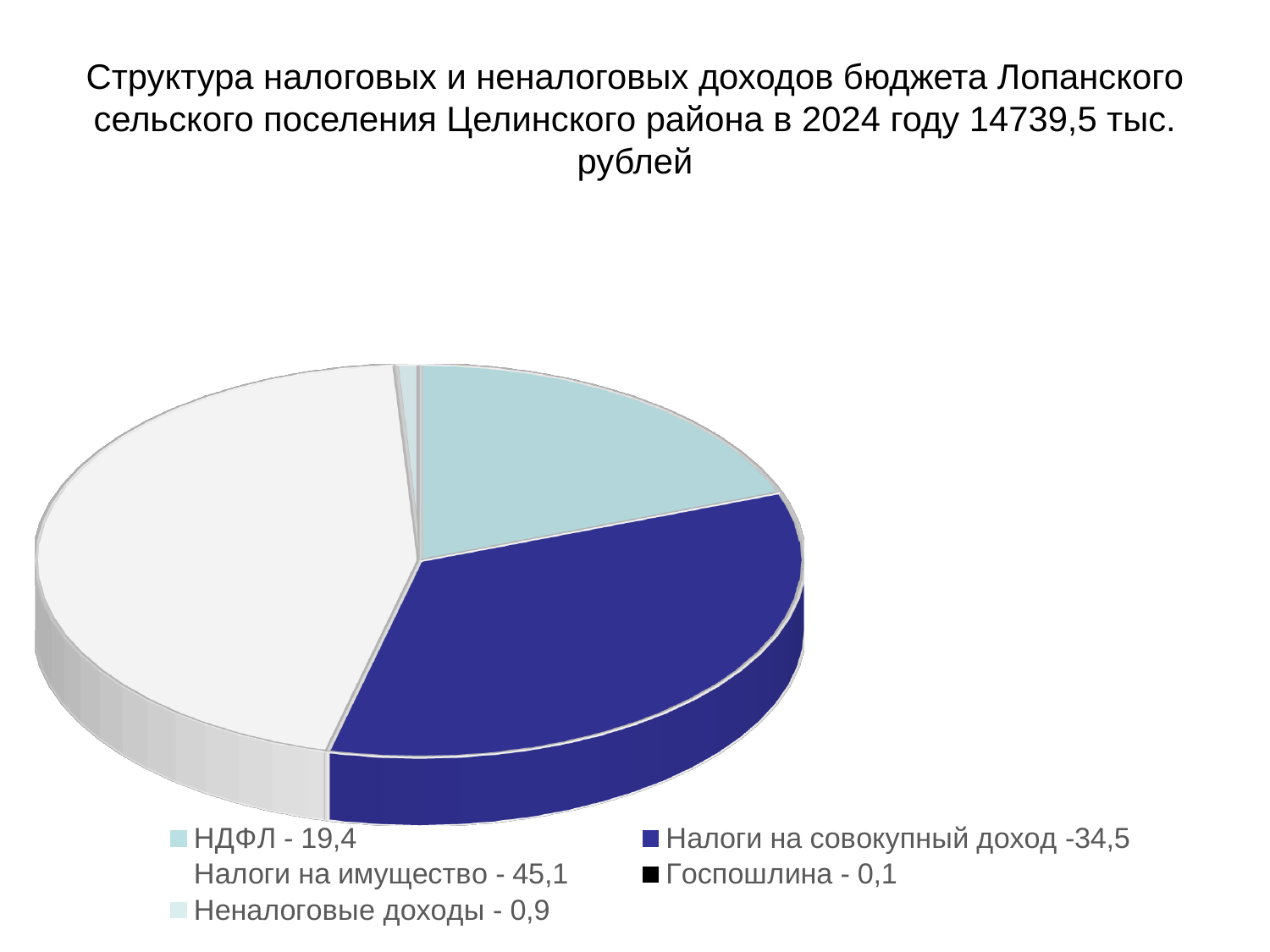
Which category has the smallest share of the pie? Госпошлина Which category has the largest share of the pie? Налоги на имущество What total amount in thousand rubles is stated in the chart title for 2024? 14739,5 тыс. рублей Which is larger: НДФЛ or Налоги на совокупный доход? Налоги на совокупный доход What value is shown for Налоги на совокупный доход? 34,5 What is the difference between the values for Налоги на имущество and Налоги на совокупный доход? 10,6 What value is shown for Неналоговые доходы? 0,9 What kind of chart is shown on the slide? Pie chart What value is shown for НДФЛ in the legend? 19,4 What value is shown for Госпошлина? 0,1 What value is shown for Налоги на имущество? 45,1 How many categories does the pie chart have? 5